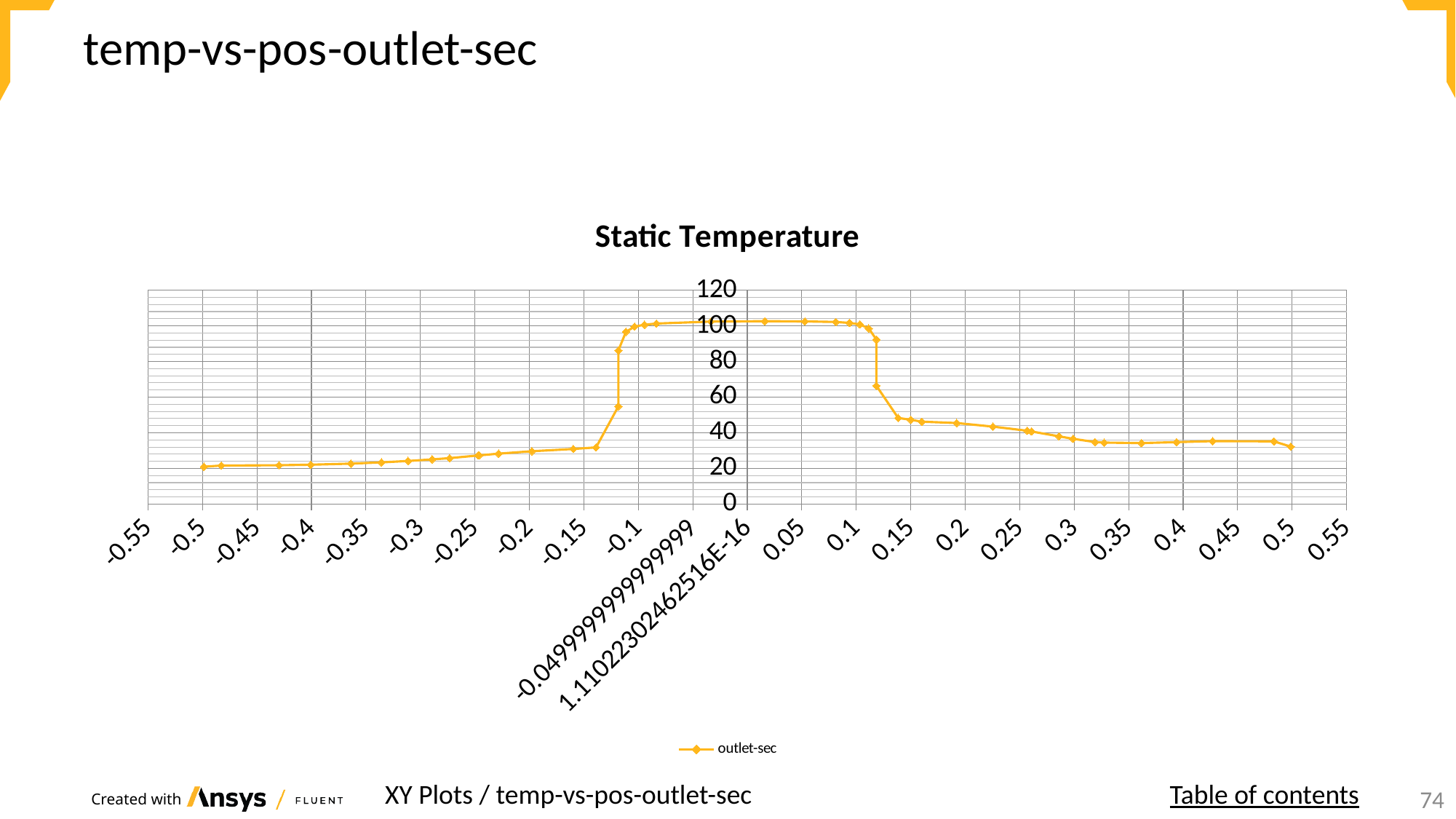
Is the value for outlet-sec at x = 0.05 greater or less than 80? greater What kind of chart is shown on the slide? line chart Which is larger, the value for outlet-sec at x = 0.05 or at x = 0.5? x = 0.05 What is the name of the series shown in the legend? outlet-sec Is the value for outlet-sec at x = 0.5 greater or less than 40? less Is the value for outlet-sec at x = 0.15 greater or less than 40? greater How many series does the legend list? 1 What is the title of the chart? Static Temperature Do the values for outlet-sec rise or fall along the x axis from x = 0.15 to x = 0.5? fall Do the values for outlet-sec rise or fall along the x axis from x = -0.5 to x = -0.15? rise